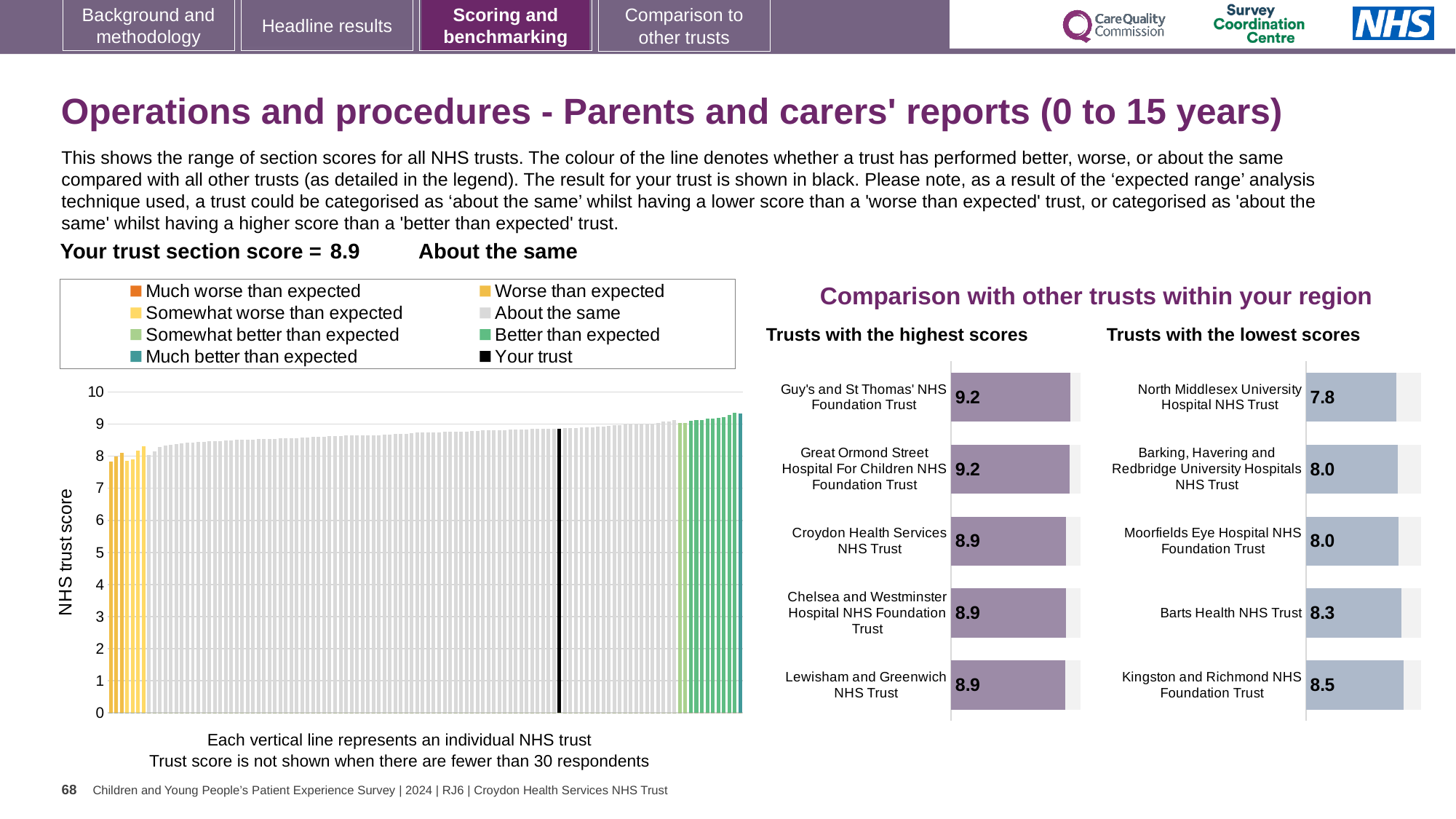
In the 'Trusts with the lowest scores' chart, what is the score for Barts Health NHS Trust? 8.3 In the 'Trusts with the highest scores' chart, what is the score for Croydon Health Services NHS Trust? 8.9 In the 'Trusts with the highest scores' chart, what is the score for Guy's and St Thomas' NHS Foundation Trust? 9.2 What kind of chart is the main chart on the left showing all NHS trusts? Bar chart In the 'Trusts with the lowest scores' chart, which trust has the highest score? Kingston and Richmond NHS Foundation Trust In the 'Trusts with the lowest scores' chart, what is the score for North Middlesex University Hospital NHS Trust? 7.8 In the 'Trusts with the lowest scores' chart, which has the higher score: Barts Health NHS Trust or Moorfields Eye Hospital NHS Foundation Trust? Barts Health NHS Trust How many trusts are shown in the 'Trusts with the highest scores' chart? 5 In the 'Trusts with the lowest scores' chart, which trust has the lowest score? North Middlesex University Hospital NHS Trust How many entries does the legend of the main chart on the left list? 8 In the 'Trusts with the lowest scores' chart, what is the difference between the scores of Kingston and Richmond NHS Foundation Trust and North Middlesex University Hospital NHS Trust? 0.7 In the main chart on the left, is the value of the rightmost (highest) bar greater or less than 9? greater